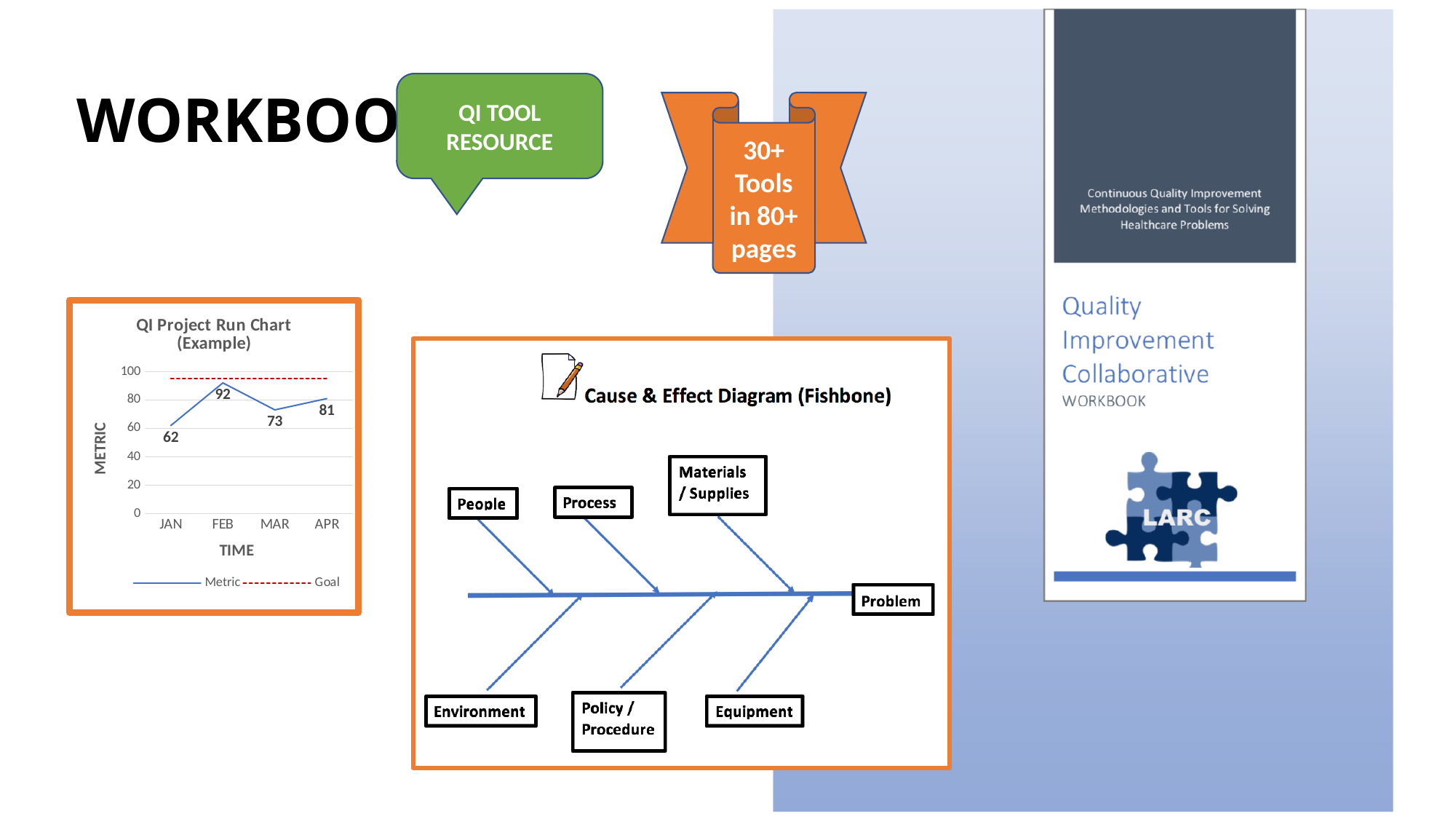
In the QI Project Run Chart (Example), is the Metric value for MAR or APR larger? APR In the QI Project Run Chart (Example), what is the difference between the Metric values for FEB and MAR? 19 In the QI Project Run Chart (Example), what is the Metric value for FEB? 92 In the QI Project Run Chart (Example), which month has the highest Metric value? FEB In the QI Project Run Chart (Example), what is the Metric value for JAN? 62 How many series does the legend of the QI Project Run Chart (Example) list? 2 In the QI Project Run Chart (Example), which month has the lowest Metric value? JAN How many months are plotted on the x axis of the QI Project Run Chart (Example)? 4 What kind of chart is the QI Project Run Chart (Example)? Line chart What is the label on the y axis of the QI Project Run Chart (Example)? METRIC In the QI Project Run Chart (Example), what is the Metric value for APR? 81 In the QI Project Run Chart (Example), is the Goal line greater or less than 80? greater